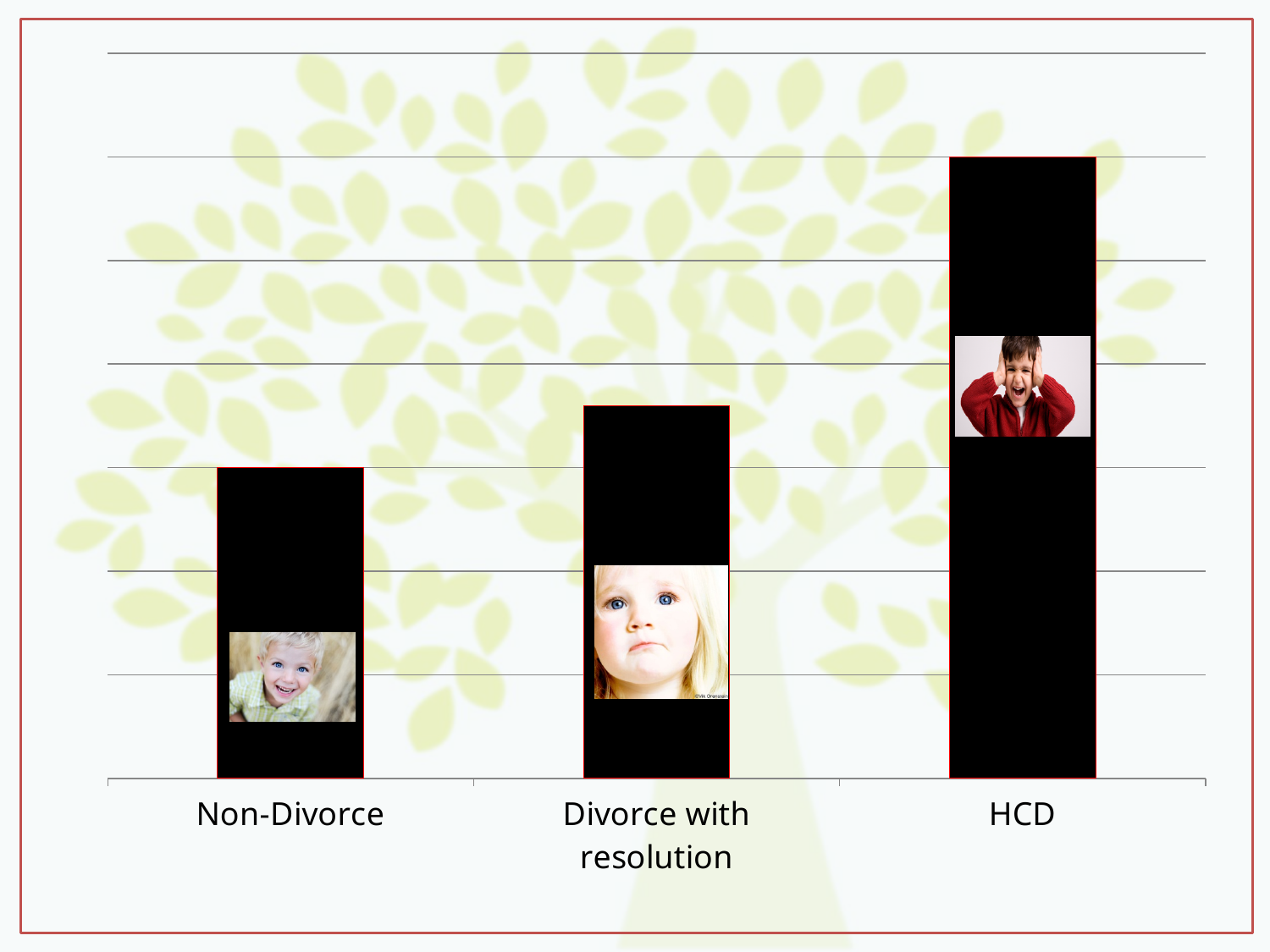
What is the label of the middle category on the x axis? Divorce with resolution Which category has the lowest bar? Non-Divorce Which is larger, the bar for Non-Divorce or the bar for Divorce with resolution? Divorce with resolution What kind of chart is shown on the slide? bar chart Which is larger, the bar for Divorce with resolution or the bar for HCD? HCD What colour are the bars in the chart? black Which category has the highest bar? HCD Do the bar values rise or fall from left to right along the x axis? rise Which is larger, the bar for Non-Divorce or the bar for HCD? HCD How many categories are plotted on the chart? 3